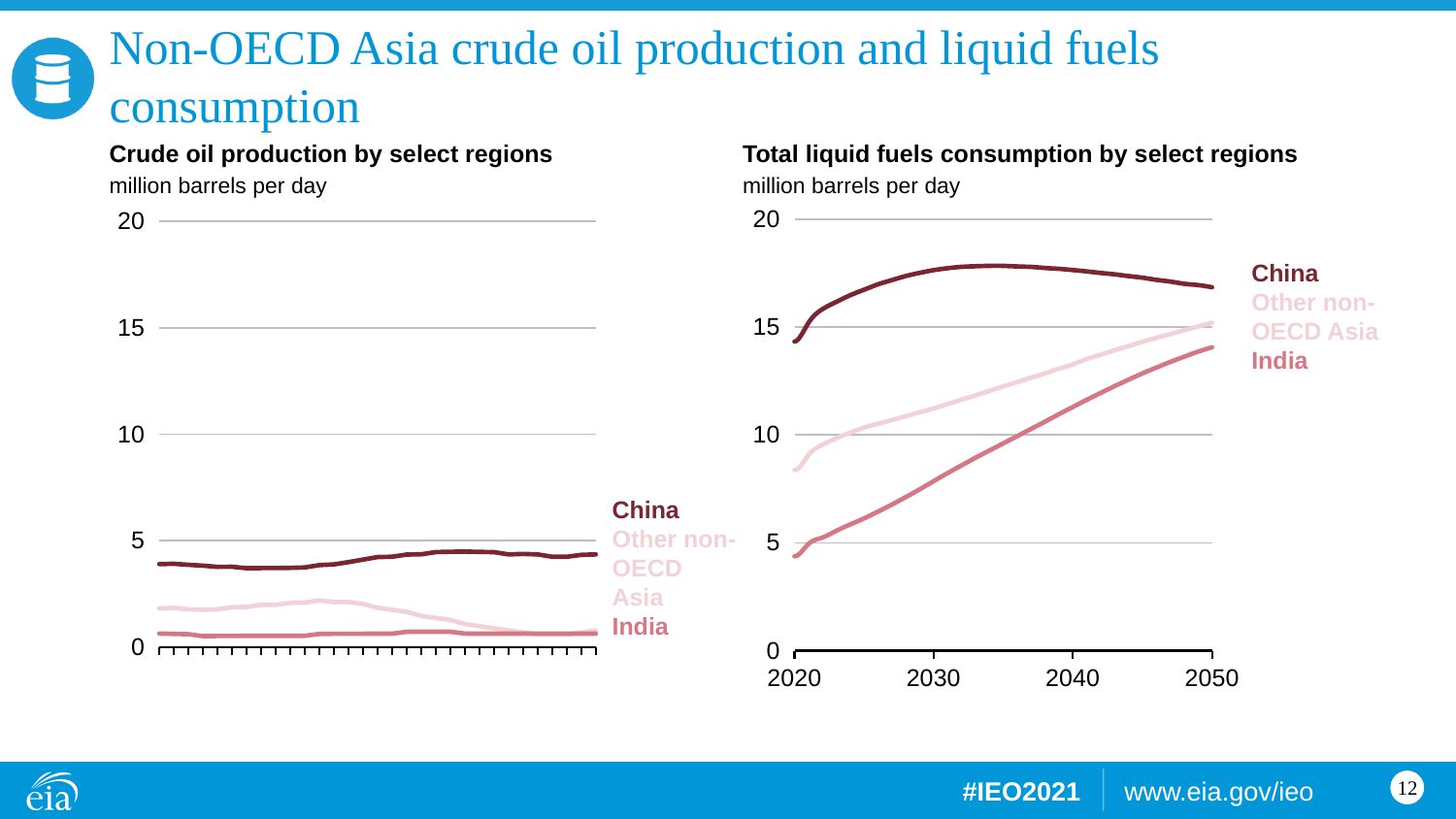
In the 'Crude oil production by select regions' chart, does the Other non-OECD Asia line rise or fall overall along the x axis? fall How many series does the legend of the 'Crude oil production by select regions' chart list? 3 In the 'Total liquid fuels consumption by select regions' chart, which region has the lowest consumption in 2020? India In the 'Total liquid fuels consumption by select regions' chart, which is larger in 2020: China or Other non-OECD Asia? China In the 'Total liquid fuels consumption by select regions' chart, is the value for India in 2020 greater or less than 5? less In the 'Total liquid fuels consumption by select regions' chart, does the India line rise or fall from 2020 to 2050? rise In the 'Total liquid fuels consumption by select regions' chart, which region has the highest consumption in 2050? China What unit is used on the y axis of both charts? million barrels per day In the 'Crude oil production by select regions' chart, is the value for China greater or less than 5? less What kind of chart is the 'Total liquid fuels consumption by select regions' chart? line chart In the 'Crude oil production by select regions' chart, which region has the highest production throughout the period? China In the 'Total liquid fuels consumption by select regions' chart, is the value for China in 2050 greater or less than 15? greater